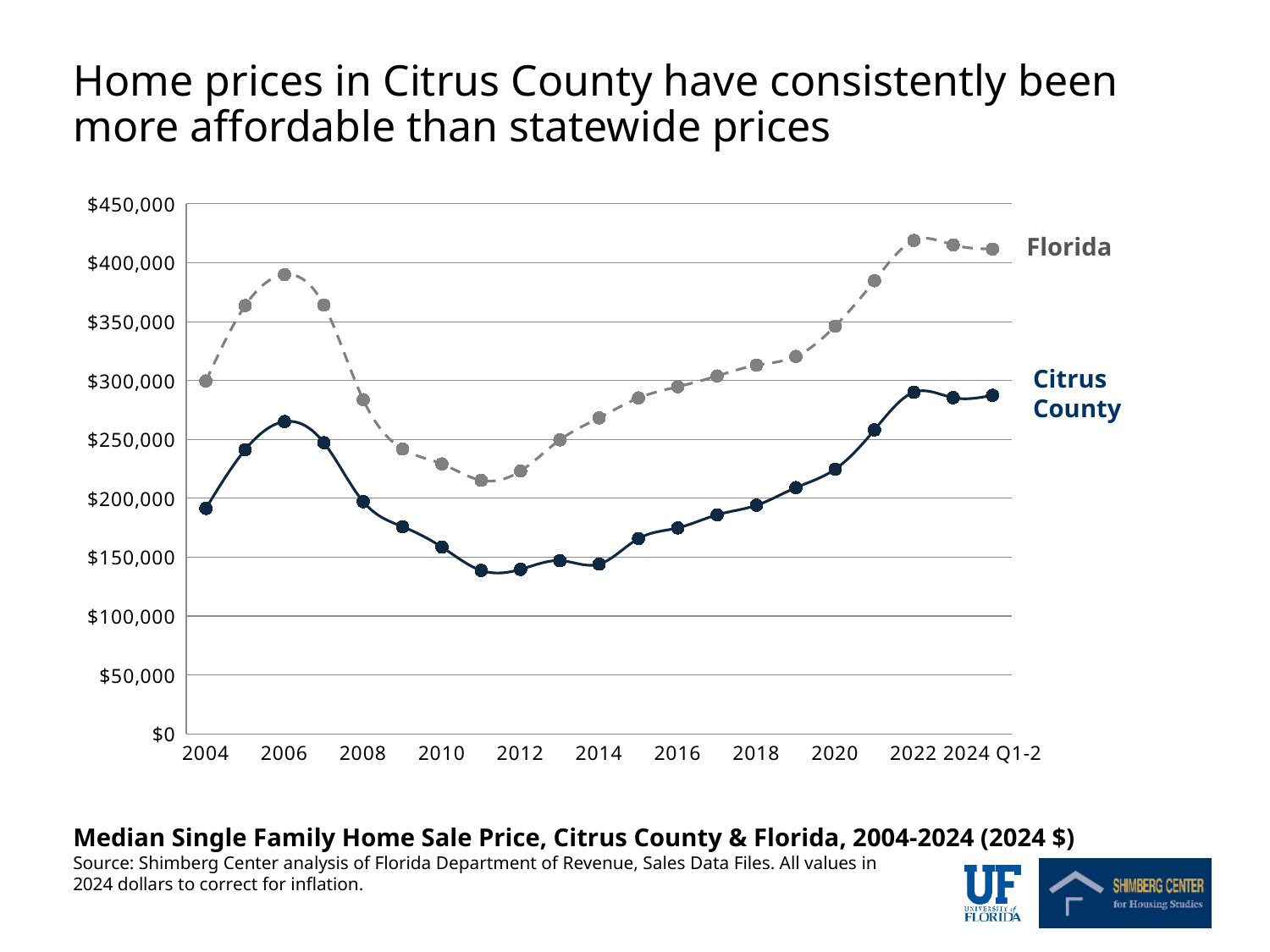
Is the Florida value for 2022 greater or less than $400,000? greater What kind of chart is shown on the slide? line chart Is the Florida value for 2006 greater or less than $400,000? less How many series does the chart show? 2 In 2020, which series has the higher value, Florida or Citrus County? Florida Does the Citrus County series rise or fall between 2012 and 2022? rise Is the Citrus County value for 2011 greater or less than $150,000? less Which two series are plotted on the chart? Florida and Citrus County What is the title of the chart? Median Single Family Home Sale Price, Citrus County & Florida, 2004-2024 (2024 $) In which year does the Citrus County series reach its highest value? 2022 In which year does the Florida series reach its highest value? 2022